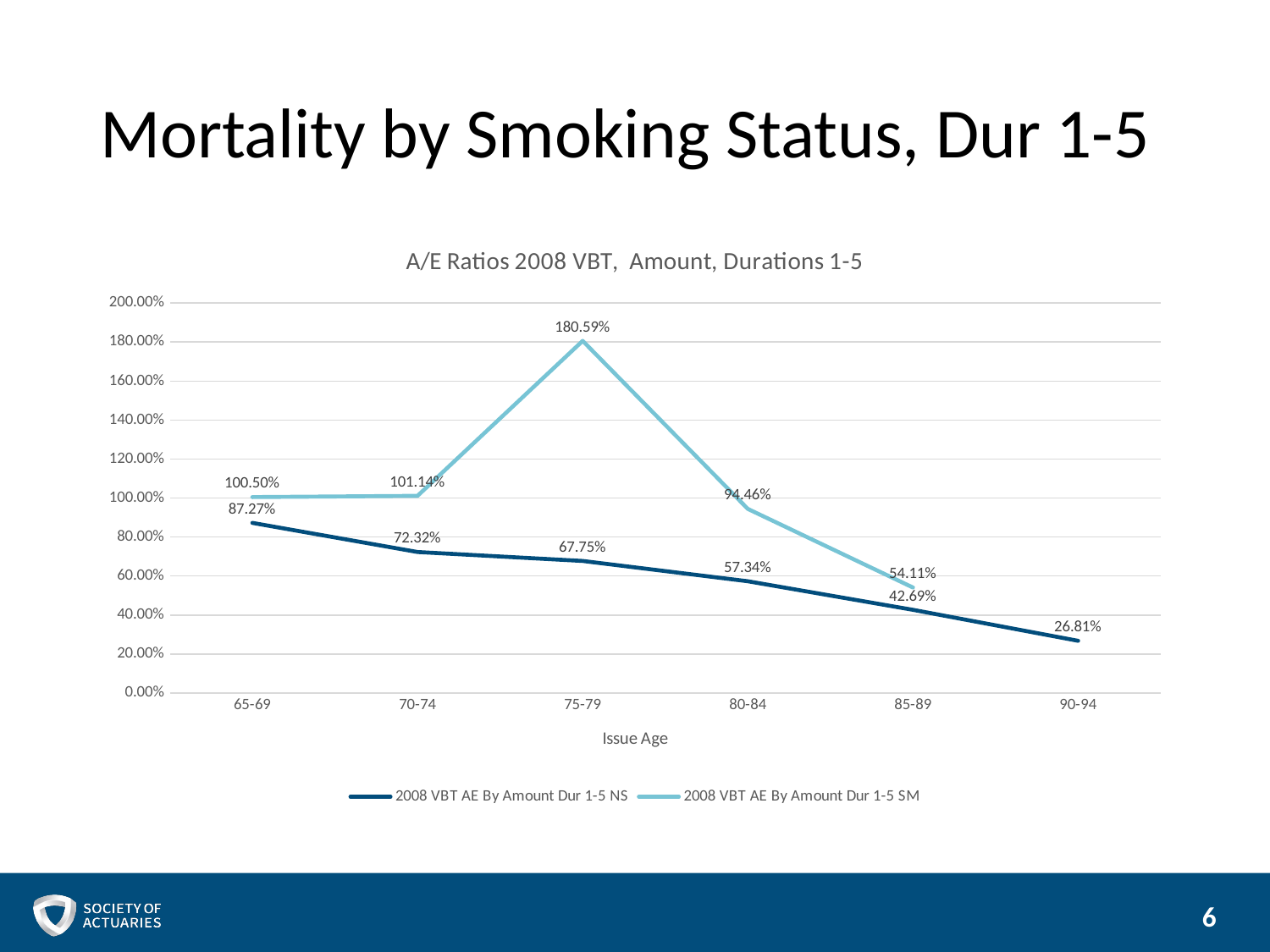
What kind of chart is shown on the slide? line chart Which series has the larger value at issue age 80-84, NS or SM? SM At which issue age does the 2008 VBT AE By Amount Dur 1-5 SM series reach its highest value? 75-79 What is the difference between the SM and NS values at issue age 85-89? 11.42% How many series does the legend list? 2 What is the value of the 2008 VBT AE By Amount Dur 1-5 NS series at issue age 90-94? 26.81% What is the value of the 2008 VBT AE By Amount Dur 1-5 SM series at issue age 75-79? 180.59% At which issue age is the 2008 VBT AE By Amount Dur 1-5 NS series lowest? 90-94 Is the value of the NS series at issue age 70-74 greater or less than 80.00%? less What is the value of the 2008 VBT AE By Amount Dur 1-5 NS series at issue age 65-69? 87.27% Does the 2008 VBT AE By Amount Dur 1-5 NS series rise or fall as issue age increases? fall How many issue age categories are shown on the x axis? 6